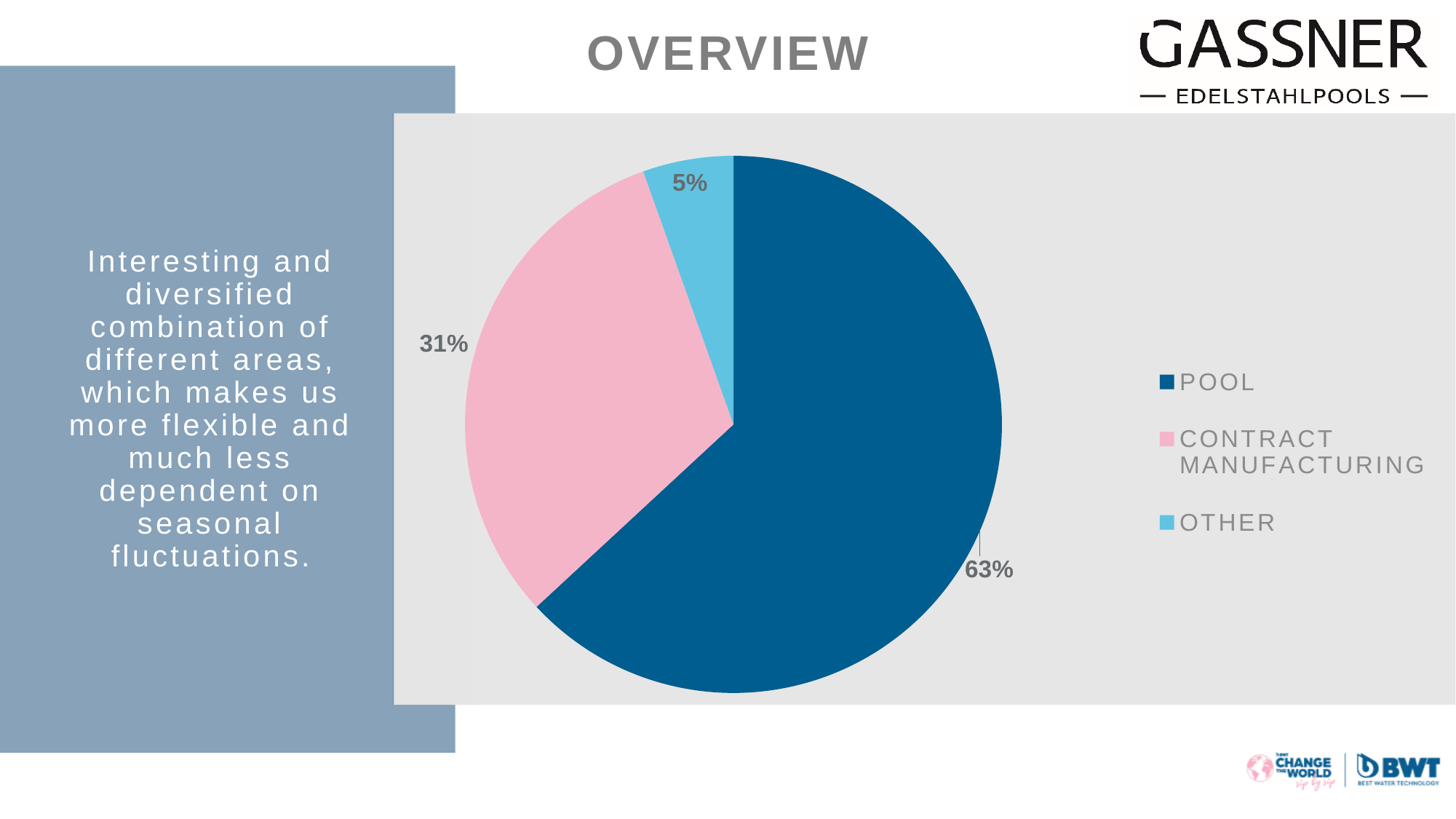
Which category has the smallest slice of the pie? OTHER Which category has the largest slice of the pie? POOL What colour is the POOL slice in the pie chart? Dark blue Which is larger, the CONTRACT MANUFACTURING slice or the OTHER slice? CONTRACT MANUFACTURING What share of the pie does CONTRACT MANUFACTURING account for? 31% How many categories are shown in the pie chart? 3 What share of the pie does POOL account for? 63% What is the difference in percentage points between the CONTRACT MANUFACTURING slice and the OTHER slice? 26 What is the difference in percentage points between the POOL slice and the CONTRACT MANUFACTURING slice? 32 What kind of chart is shown on the slide? Pie chart What share of the pie does OTHER account for? 5% What is the title shown above the chart? OVERVIEW